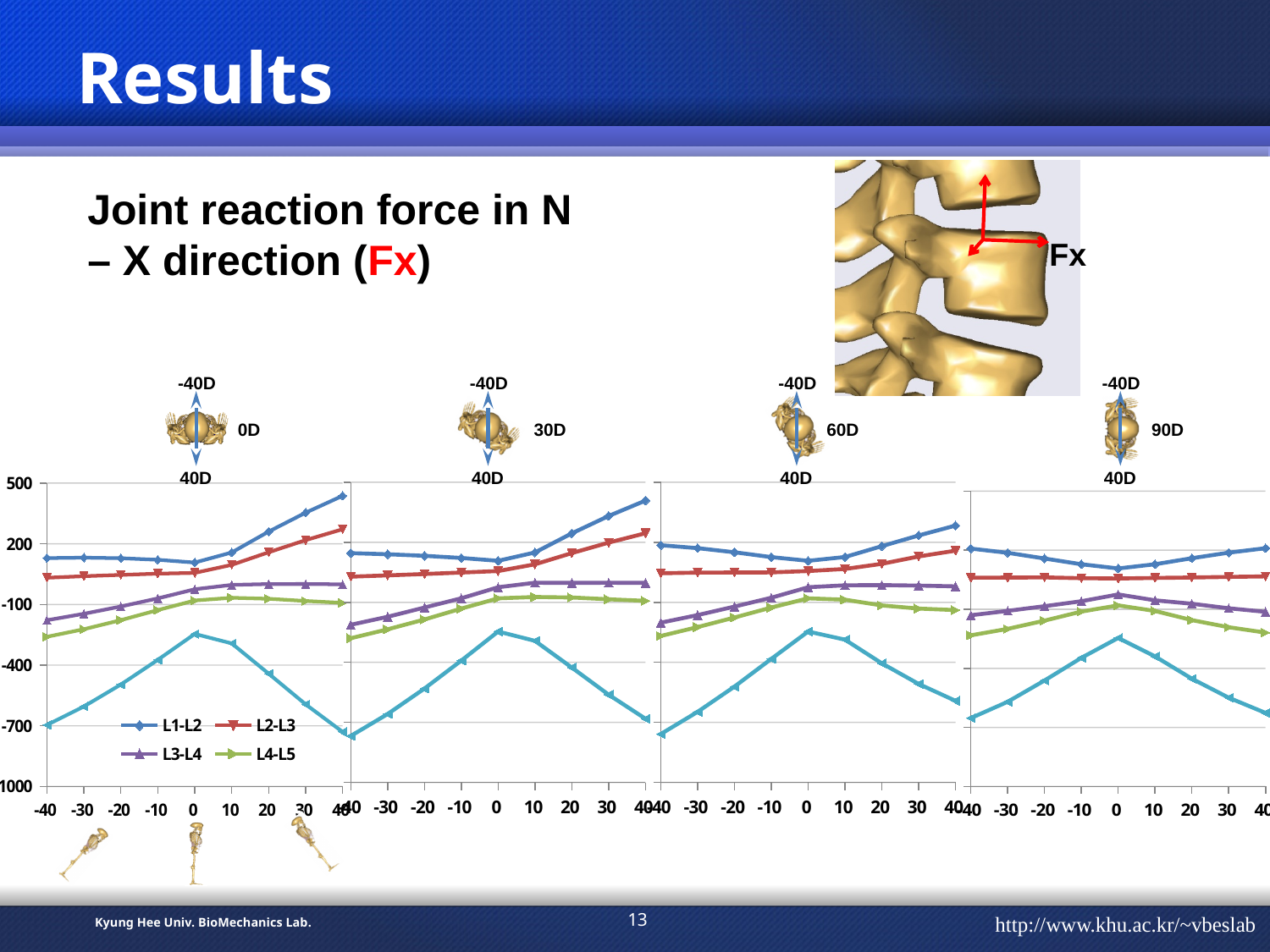
How many series does the legend in the 0D chart list? 4 What colour is the L1-L2 series in the legend? blue In the 0D chart, is the value of L1-L2 at x = 40 greater or less than 200? greater In the 60D chart, does the L2-L3 series rise or fall from x = -40 to x = 40? rise In the 90D chart, is the value of L1-L2 at x = 0 greater or less than 200? less In the 30D chart, is the value of L1-L2 at x = 40 greater or less than 200? greater In the 0D chart, does the L1-L2 series rise or fall from x = -40 to x = 40? rise What kind of chart is used for the 0D panel? line chart How many chart panels (0D, 30D, 60D, 90D) are shown on the slide? 4 How many x-axis points are plotted in the 0D chart? 9